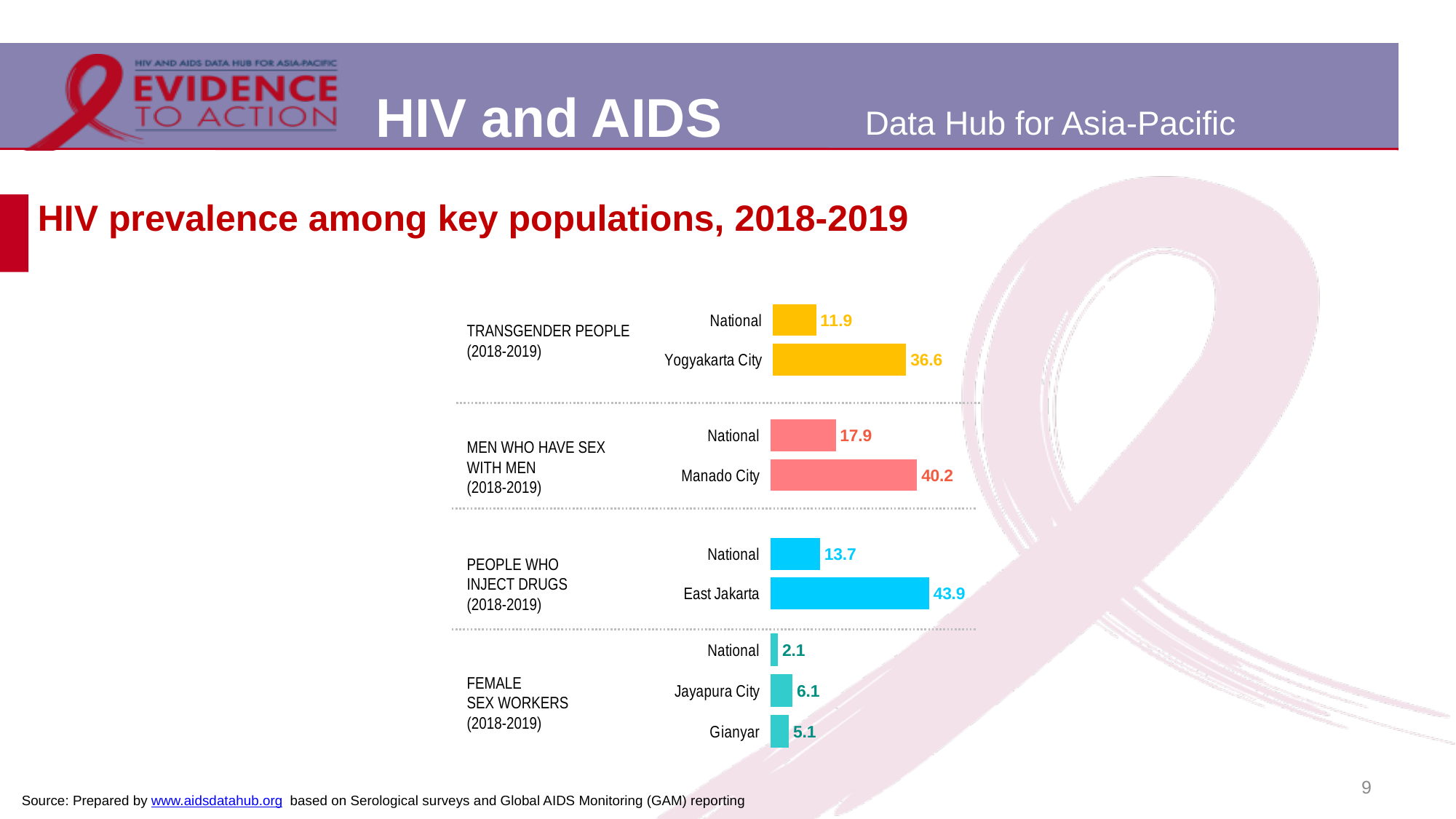
Which bar in the chart has the lowest value? National (female sex workers) How many key population groups does the chart cover? 4 What is the national HIV prevalence value among men who have sex with men? 17.9 Which is larger: the national value for transgender people or the national value for people who inject drugs? People who inject drugs (13.7) What kind of chart is shown on the slide? Bar chart What is the HIV prevalence value for Yogyakarta City among transgender people? 36.6 What is the HIV prevalence value for East Jakarta among people who inject drugs? 43.9 What is the HIV prevalence value for Gianyar among female sex workers? 5.1 How many bars are plotted in the chart in total? 9 What is the difference between the Jayapura City and Gianyar values among female sex workers? 1.0 Which bar in the chart has the highest value? East Jakarta (people who inject drugs) What is the difference between the Manado City value and the national value among men who have sex with men? 22.3